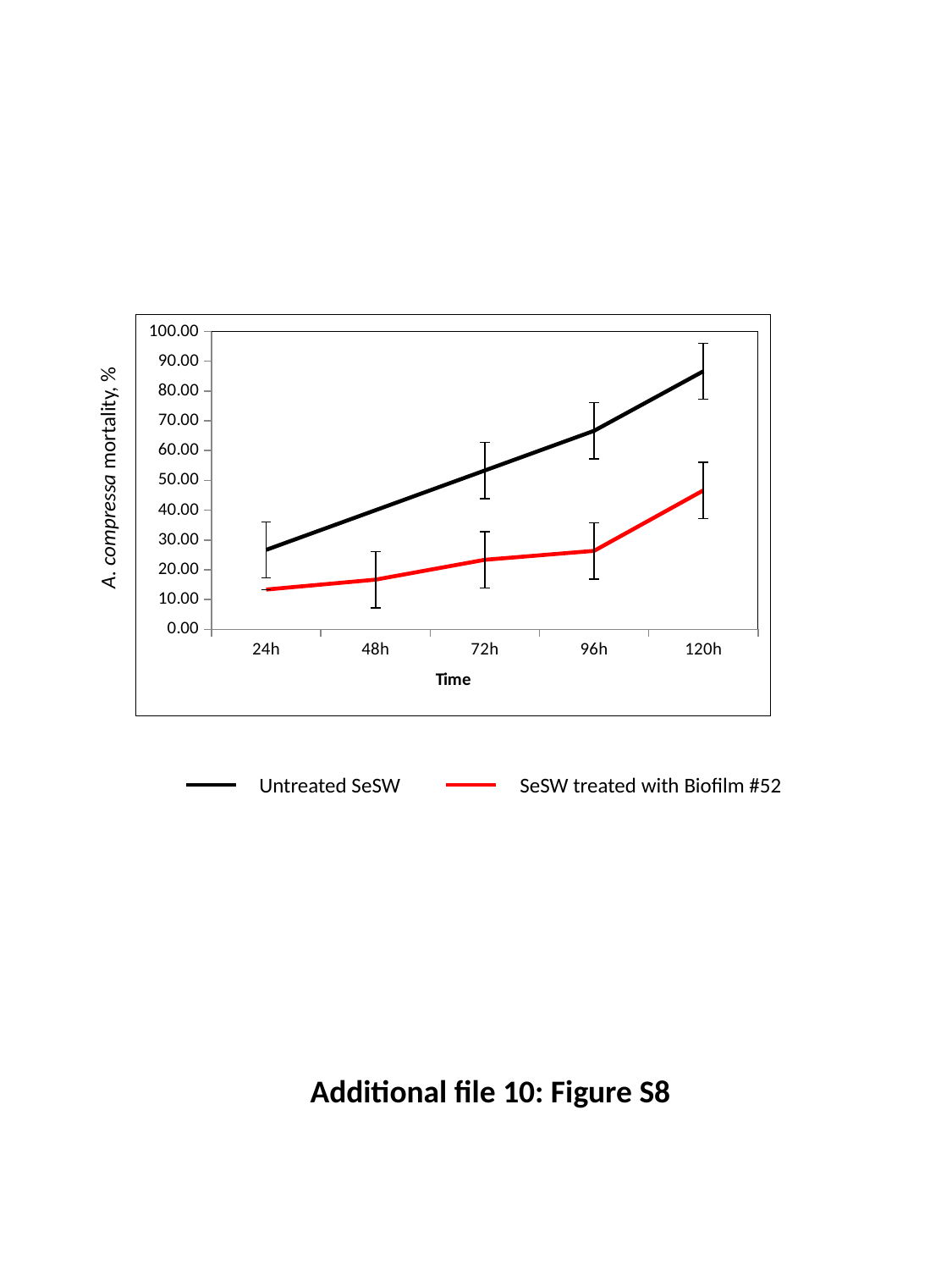
What is the title of the x axis? Time Is the SeSW treated with Biofilm #52 value at 24h greater or less than 20.00? less At which time point is the Untreated SeSW mortality highest? 120h How many series does the legend list? 2 Does the SeSW treated with Biofilm #52 series rise or fall from 24h to 120h? rise How many time points are plotted along the x axis? 5 Is the Untreated SeSW value at 120h greater or less than 80.00? greater Is the SeSW treated with Biofilm #52 value at 120h greater or less than 40.00? greater Does the Untreated SeSW series rise or fall from 24h to 120h? rise At which time point is the SeSW treated with Biofilm #52 mortality lowest? 24h At 72h, which series has the higher mortality, Untreated SeSW or SeSW treated with Biofilm #52? Untreated SeSW What kind of chart is shown on the slide? line chart